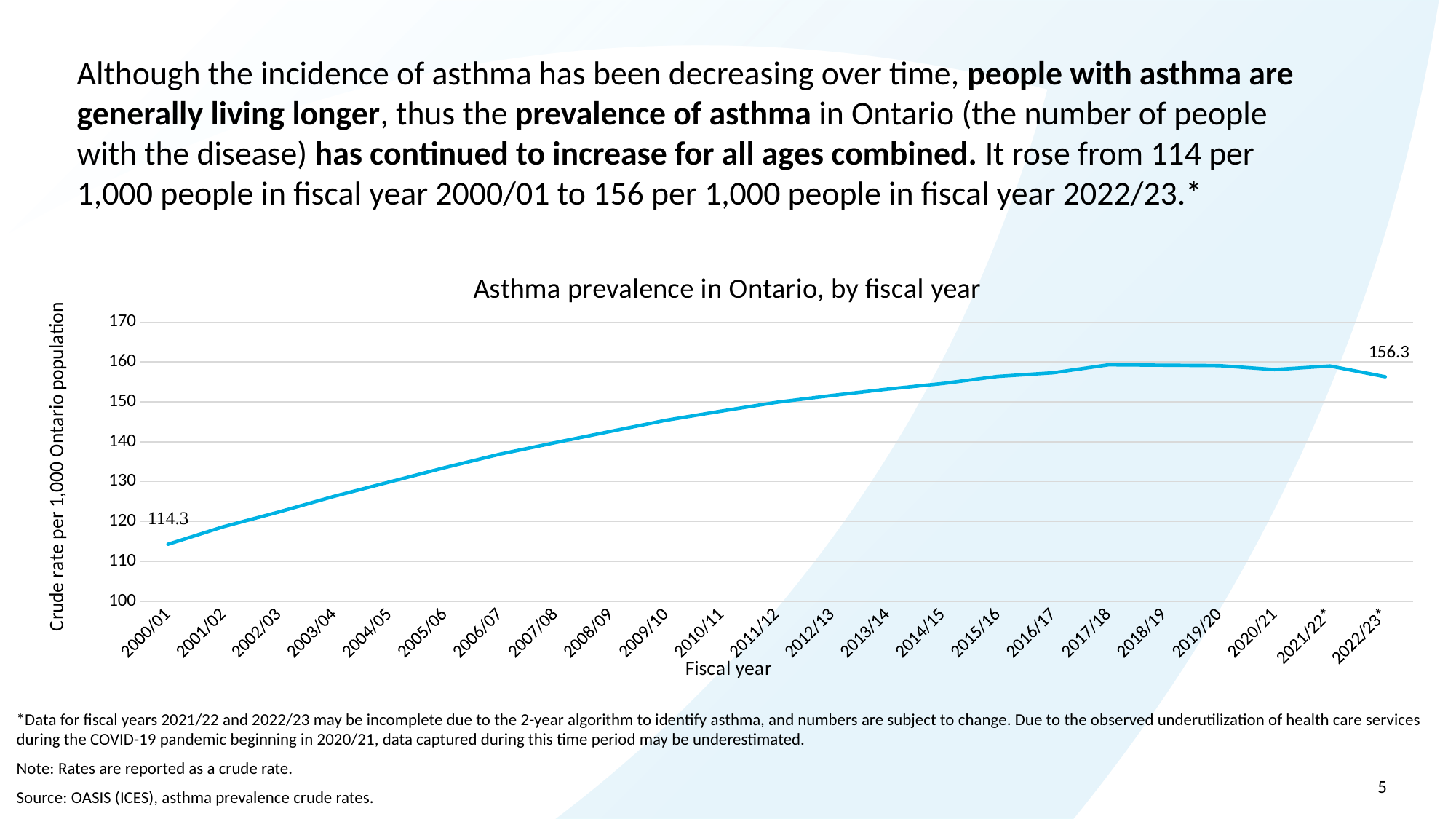
What type of chart is shown on the slide? Line chart Is the value for 2017/18 greater or less than 150? greater Is the value for 2010/11 greater or less than 140? greater What is the asthma prevalence crude rate for fiscal year 2022/23? 156.3 What is the title of the chart? Asthma prevalence in Ontario, by fiscal year Is the value for 2005/06 greater or less than 140? less Does the asthma prevalence crude rate generally rise or fall from 2000/01 to 2022/23? Rise Which fiscal year has a higher crude rate, 2000/01 or 2022/23? 2022/23 What is the asthma prevalence crude rate for fiscal year 2000/01? 114.3 What is the difference between the crude rate in 2022/23 and the crude rate in 2000/01? 42 Which fiscal year has the lowest asthma prevalence crude rate? 2000/01 How many fiscal years are plotted on the x axis? 23